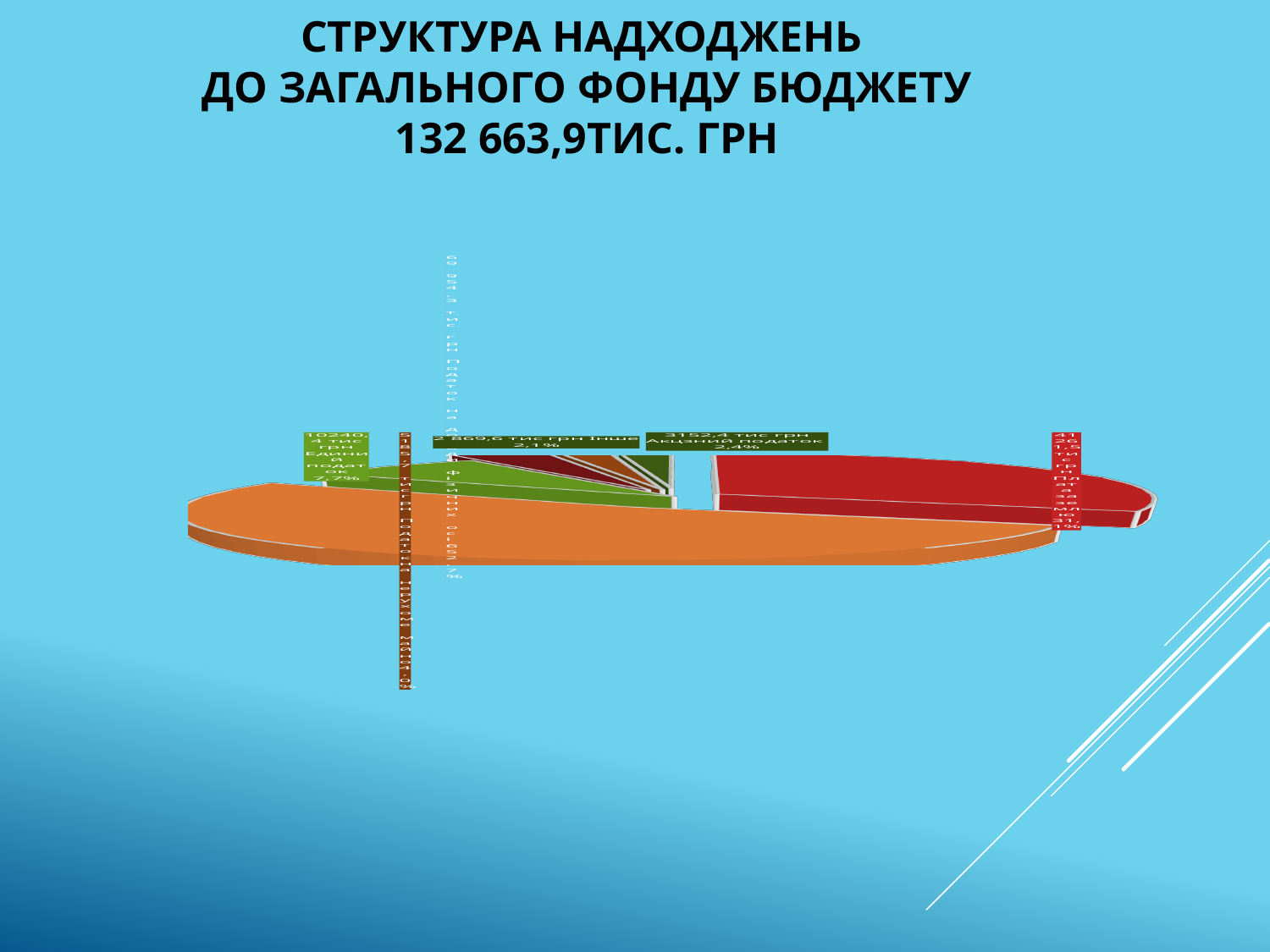
What amount in тис грн is shown for Акцизний податок? 3152,4 тис грн What share of revenues is labelled Інше? 2,1% What is the difference in percentage points between the shares of Єдиний податок and Акцизний податок? 5,3% Which has a larger share, Єдиний податок or Акцизний податок? Єдиний податок What share of revenues does Акцизний податок account for? 2,4% What total amount is stated in the chart title for the general fund revenues? 132 663,9 тис. грн What amount in тис грн is shown for the slice labelled Інше? 2 869,6 тис грн What amount in тис грн is shown for Єдиний податок? 10240,4 тис грн What kind of chart is shown on the slide? pie chart What share of revenues does Єдиний податок account for? 7,7% What is the difference in percentage points between the shares of Акцизний податок and Інше? 0,3%